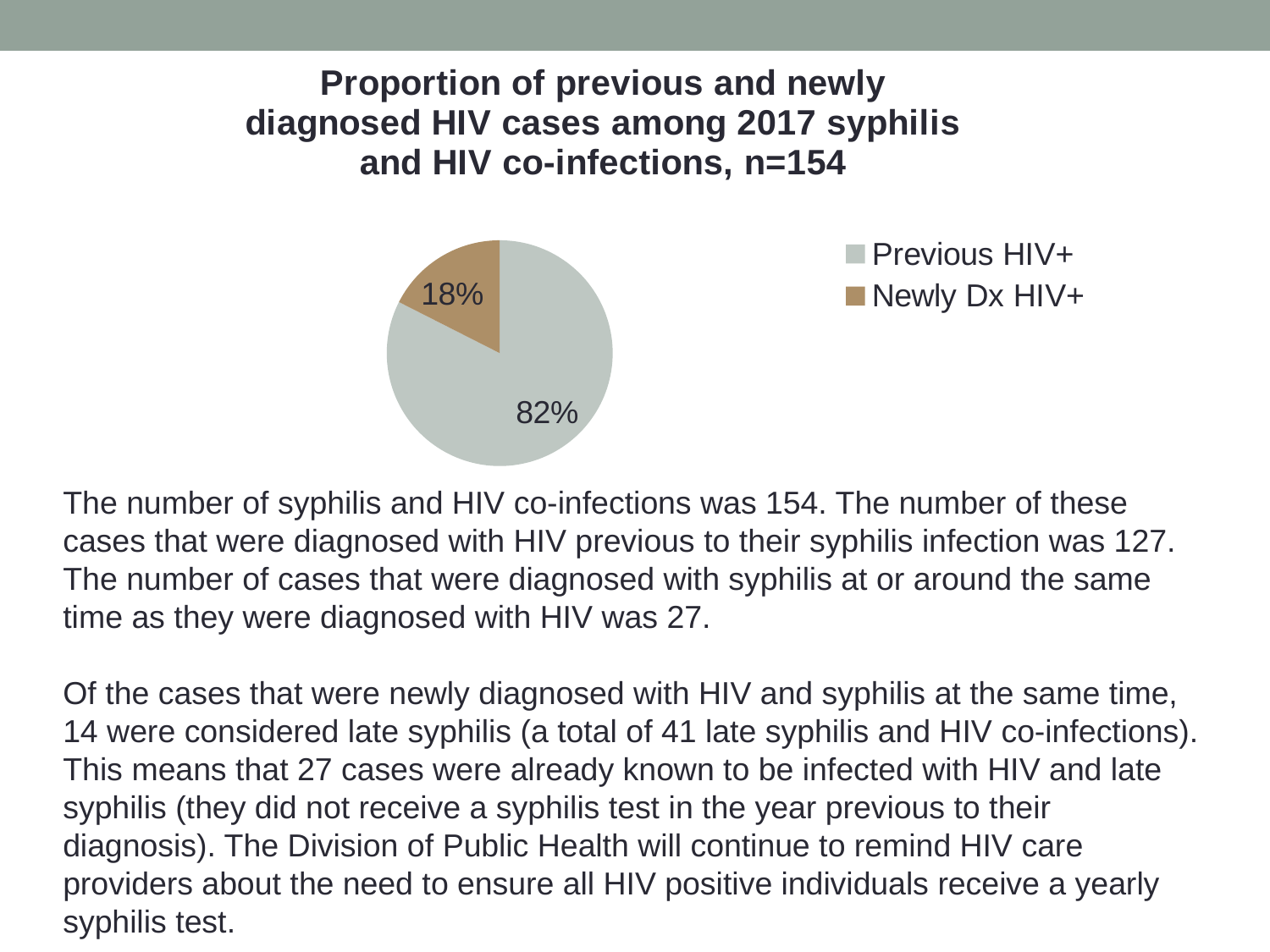
What kind of chart is shown on the slide? pie chart How many slices does the pie chart have? 2 Which slice of the pie is the smallest? Newly Dx HIV+ What share of the pie is Previous HIV+? 82% What is the n value given in the chart title? n=154 What is the difference in percentage points between the Previous HIV+ and Newly Dx HIV+ slices? 64 Which legend entry is shown in brown? Newly Dx HIV+ How many entries does the legend list? 2 What share of the pie is Newly Dx HIV+? 18% Which slice of the pie is the largest? Previous HIV+ Which is larger, the Previous HIV+ slice or the Newly Dx HIV+ slice? Previous HIV+